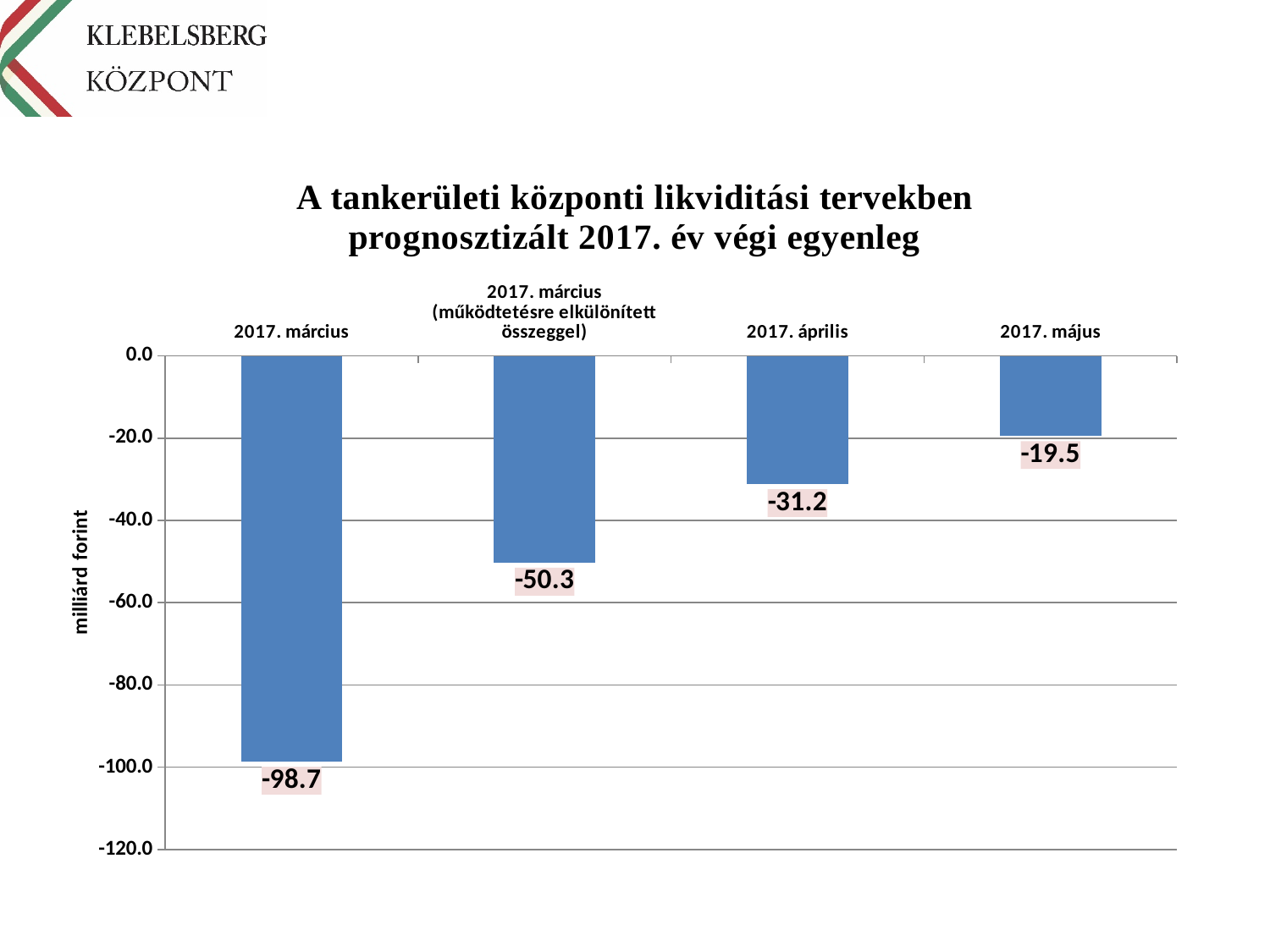
What is the label of the vertical axis? milliárd forint What is the value for 2017. május? -19.5 Which category has the lowest (most negative) value? 2017. március What is the value for 2017. március (működtetésre elkülönített összeggel)? -50.3 How many categories are shown in the chart? 4 Which category has the highest (least negative) value? 2017. május What is the value for 2017. április? -31.2 Which is larger, the value for 2017. április or the value for 2017. május? 2017. május What is the value for 2017. március? -98.7 What is the difference between the values for 2017. március and 2017. március (működtetésre elkülönített összeggel)? 48.4 What kind of chart is shown on the slide? bar chart What is the difference between the values for 2017. április and 2017. május? 11.7